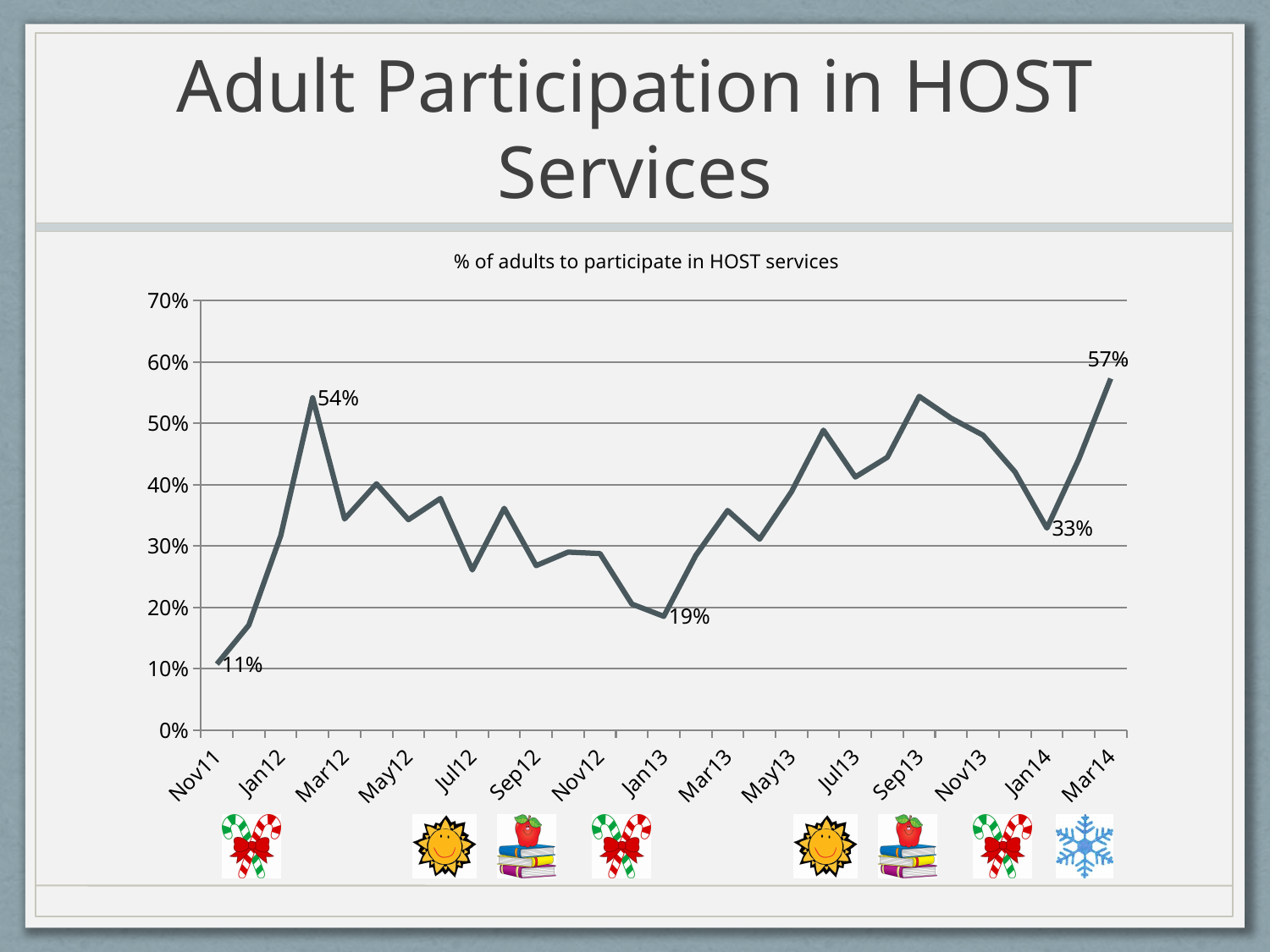
What is the value for Jan13? 19% What is the title of the chart? % of adults to participate in HOST services What is the value for Jan14? 33% Is the value for Sep13 greater or less than 50%? greater What is the value for Nov11? 11% What is the value for Mar14? 57% Which month has the lowest value on the chart? Nov11 Which is larger, the value for Jan14 or the value for Jan13? Jan14 Is the value for Jul12 greater or less than 30%? less Which month has the highest value on the chart? Mar14 What is the difference between the values for Mar14 and Jan14? 24 percentage points What kind of chart is shown on the slide? Line chart